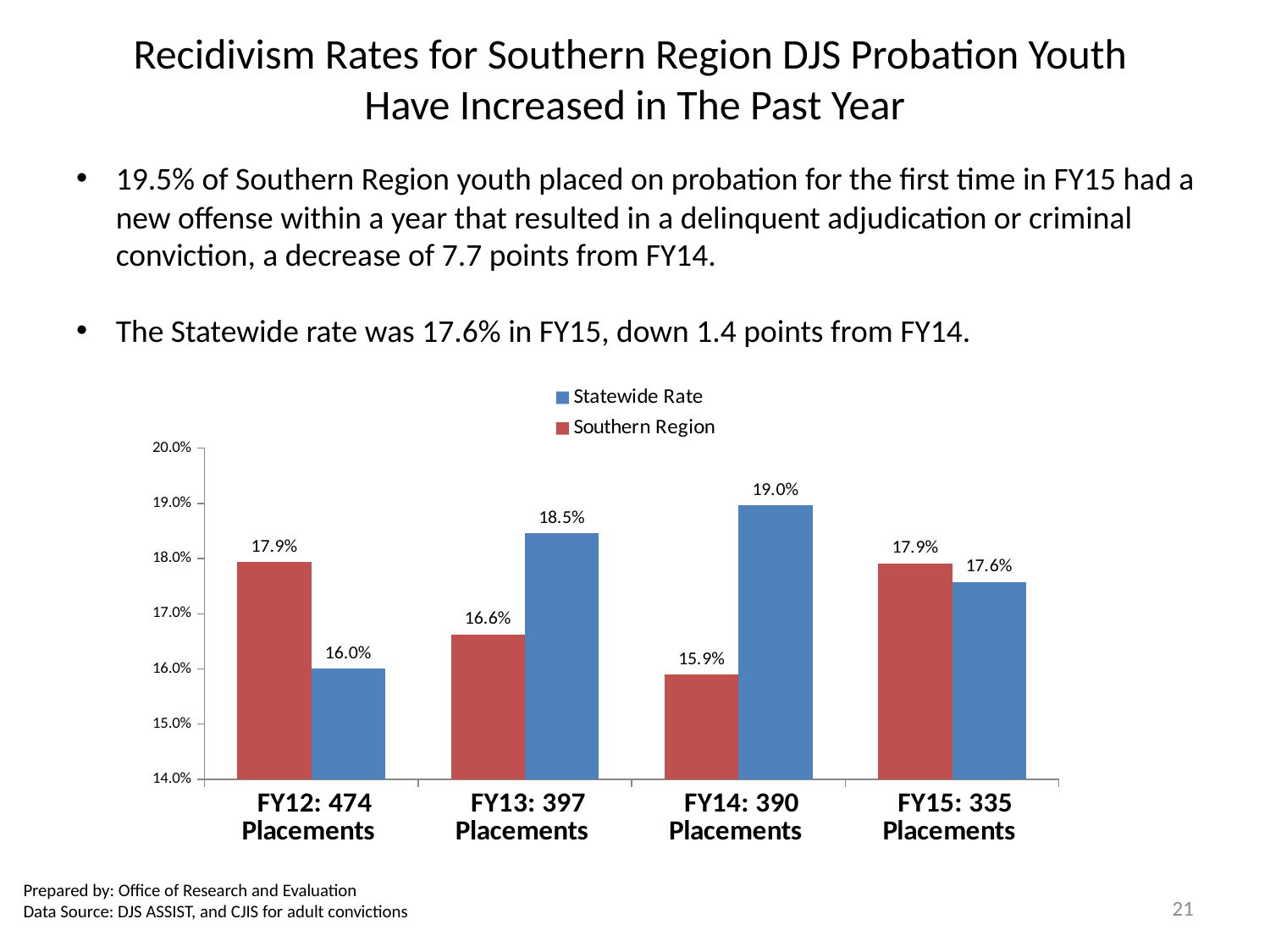
What is the difference between the Statewide Rate and the Southern Region rate for FY14: 390 Placements? 3.1 percentage points What is the Statewide Rate for FY14: 390 Placements? 19.0% How many series does the legend list? 2 In which fiscal year category is the Southern Region rate lowest? FY14: 390 Placements Which colour represents the Southern Region series in the chart? Red How many fiscal year categories are shown on the x axis? 4 What is the Southern Region recidivism rate for FY12: 474 Placements? 17.9% In which fiscal year category is the Statewide Rate highest? FY14: 390 Placements What is the Statewide Rate for FY15: 335 Placements? 17.6% What kind of chart is shown on the slide? Bar chart For FY12: 474 Placements, which is larger, the Statewide Rate or the Southern Region rate? Southern Region Is the Statewide Rate for FY13: 397 Placements greater or less than 18.0%? greater